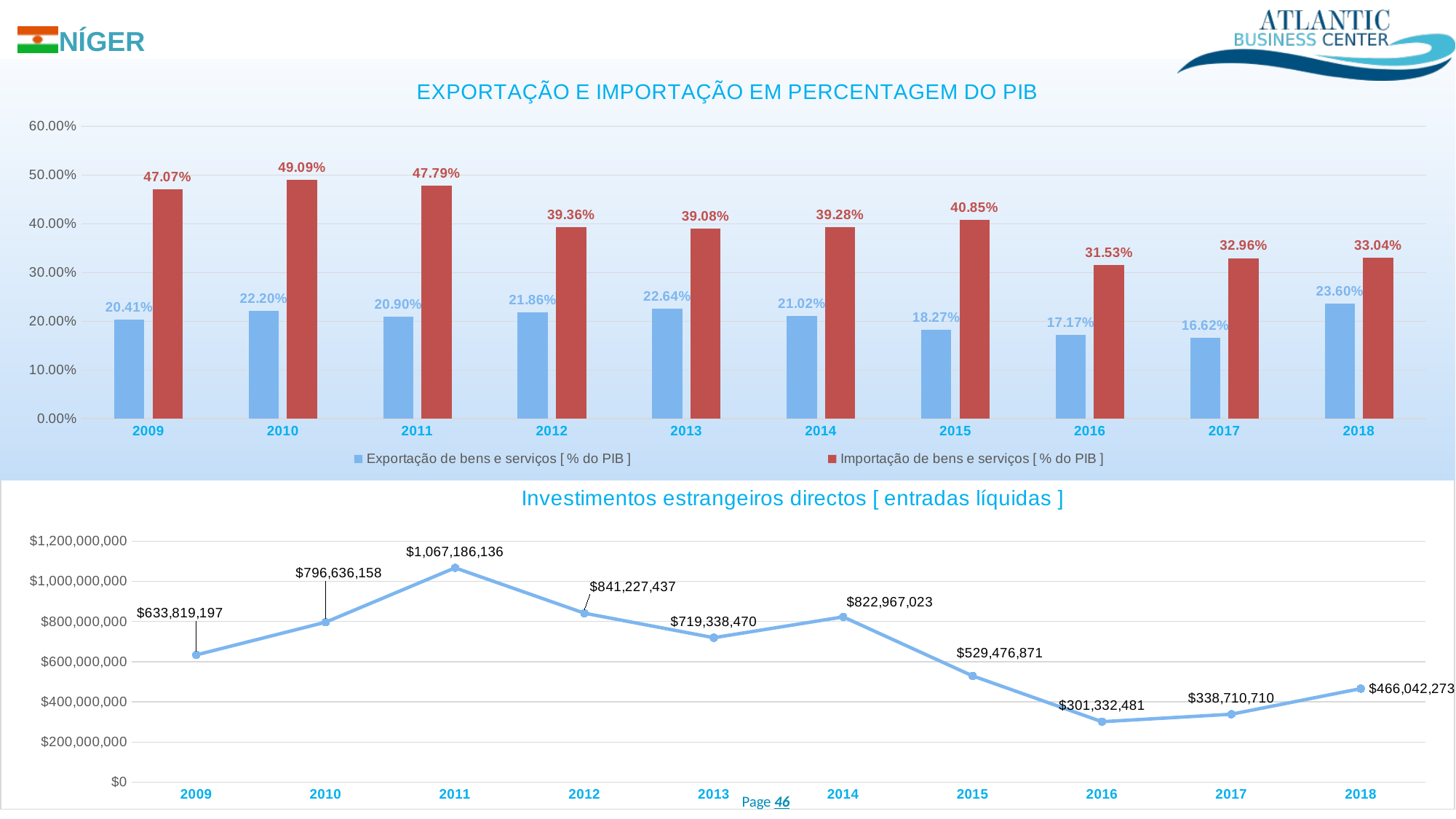
In the bottom chart 'Investimentos estrangeiros directos [ entradas líquidas ]', which year has the lowest value? 2016 What kind of chart is the top chart 'EXPORTAÇÃO E IMPORTAÇÃO EM PERCENTAGEM DO PIB'? Bar chart In the bottom chart 'Investimentos estrangeiros directos [ entradas líquidas ]', is the value for 2014 larger or smaller than the value for 2015? Larger In the bottom chart 'Investimentos estrangeiros directos [ entradas líquidas ]', how many years are plotted? 10 In the bottom chart 'Investimentos estrangeiros directos [ entradas líquidas ]', what is the value for 2011? $1,067,186,136 In the top chart 'EXPORTAÇÃO E IMPORTAÇÃO EM PERCENTAGEM DO PIB', what is the value of Importação de bens e serviços for 2010? 49.09% What kind of chart is the bottom chart 'Investimentos estrangeiros directos [ entradas líquidas ]'? Line chart In the top chart 'EXPORTAÇÃO E IMPORTAÇÃO EM PERCENTAGEM DO PIB', what is the difference between Importação and Exportação in 2010? 26.89% In the top chart 'EXPORTAÇÃO E IMPORTAÇÃO EM PERCENTAGEM DO PIB', how many series does the legend list? 2 In the top chart 'EXPORTAÇÃO E IMPORTAÇÃO EM PERCENTAGEM DO PIB', what is the value of Exportação de bens e serviços for 2015? 18.27% In the top chart 'EXPORTAÇÃO E IMPORTAÇÃO EM PERCENTAGEM DO PIB', which year has the highest Importação de bens e serviços value? 2010 In the top chart 'EXPORTAÇÃO E IMPORTAÇÃO EM PERCENTAGEM DO PIB', which year has the lowest Exportação de bens e serviços value? 2017